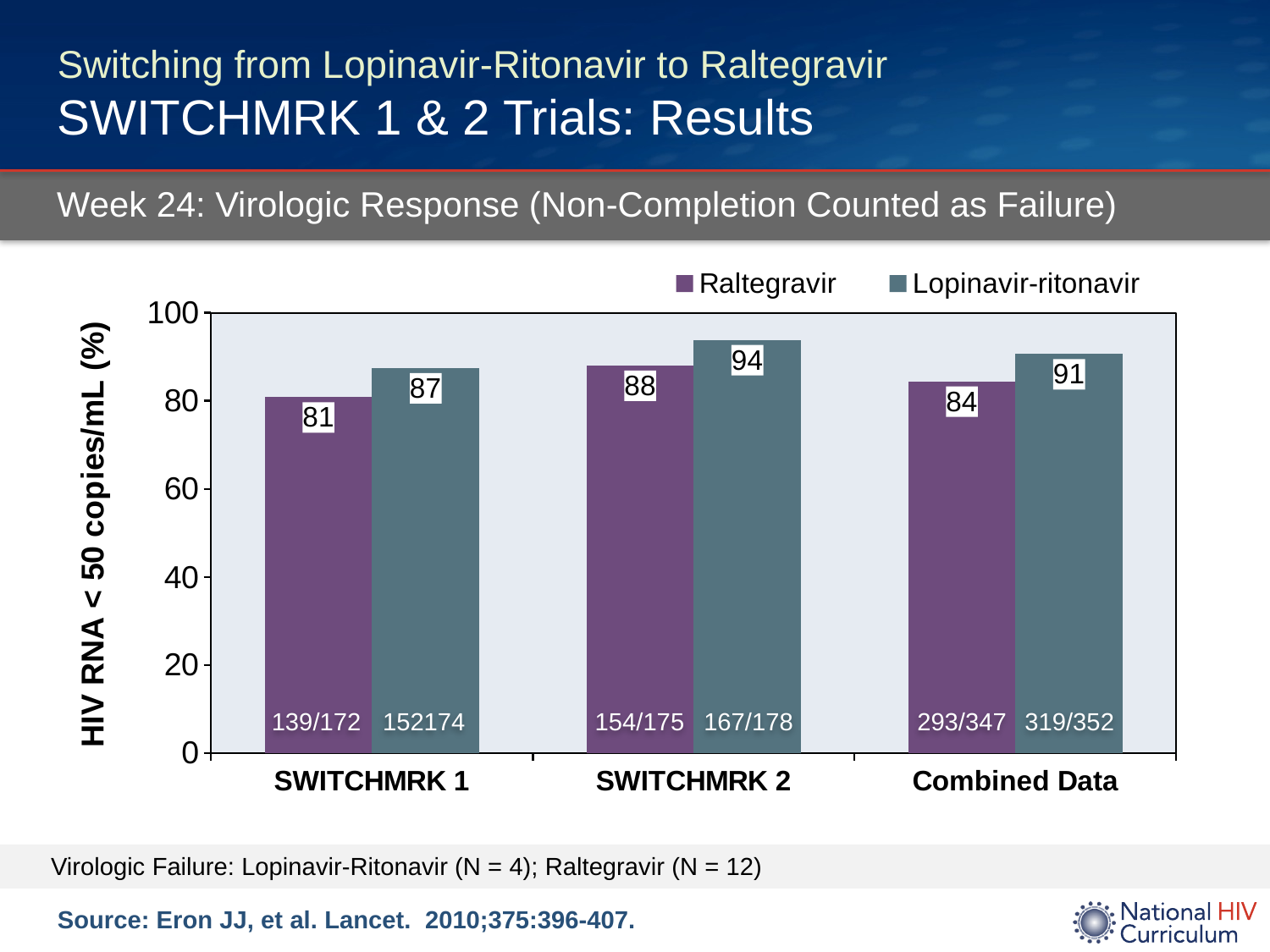
What is the value for Lopinavir-ritonavir in SWITCHMRK 1? 87 What kind of chart is shown on the slide? Bar chart What is the value for Raltegravir in the Combined Data group? 84 What is the difference between the Lopinavir-ritonavir and Raltegravir values in SWITCHMRK 2? 6 What is the value for Lopinavir-ritonavir in SWITCHMRK 2? 94 What is the y-axis label of the chart? HIV RNA < 50 copies/mL (%) What is the value for Raltegravir in SWITCHMRK 1? 81 How many series does the legend list? 2 Which group has the highest Lopinavir-ritonavir value? SWITCHMRK 2 Which group has the lowest Raltegravir value? SWITCHMRK 1 In the Combined Data group, which series has the larger value, Raltegravir or Lopinavir-ritonavir? Lopinavir-ritonavir How many groups are shown on the x axis? 3